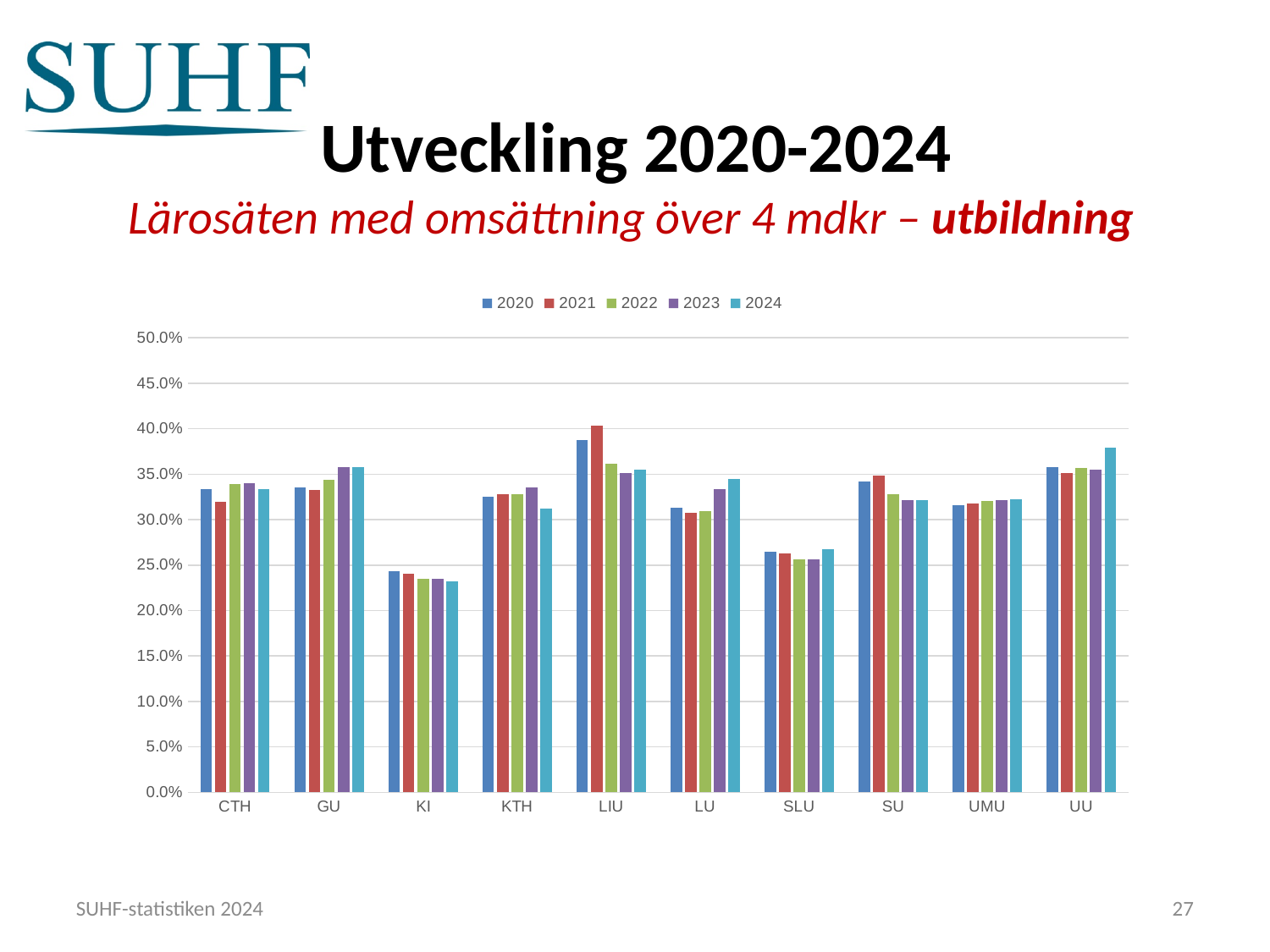
Is the value for LIU in 2020 greater or less than 35.0%? greater Which institution has the lowest values across all years? KI Which is larger, the 2024 value for UU or the 2024 value for UMU? UU How many series does the legend list? 5 Which years are listed in the legend? 2020, 2021, 2022, 2023, 2024 Which institution has the lowest value for 2024? KI What kind of chart is shown on the slide? bar chart How many institutions (categories) are shown on the x axis? 10 Which institution has the highest value for 2024? UU Is the value for SLU in 2021 greater or less than 30.0%? less Which is larger, the 2021 value for LIU or the 2021 value for LU? LIU Is the value for KI in 2024 greater or less than 25.0%? less